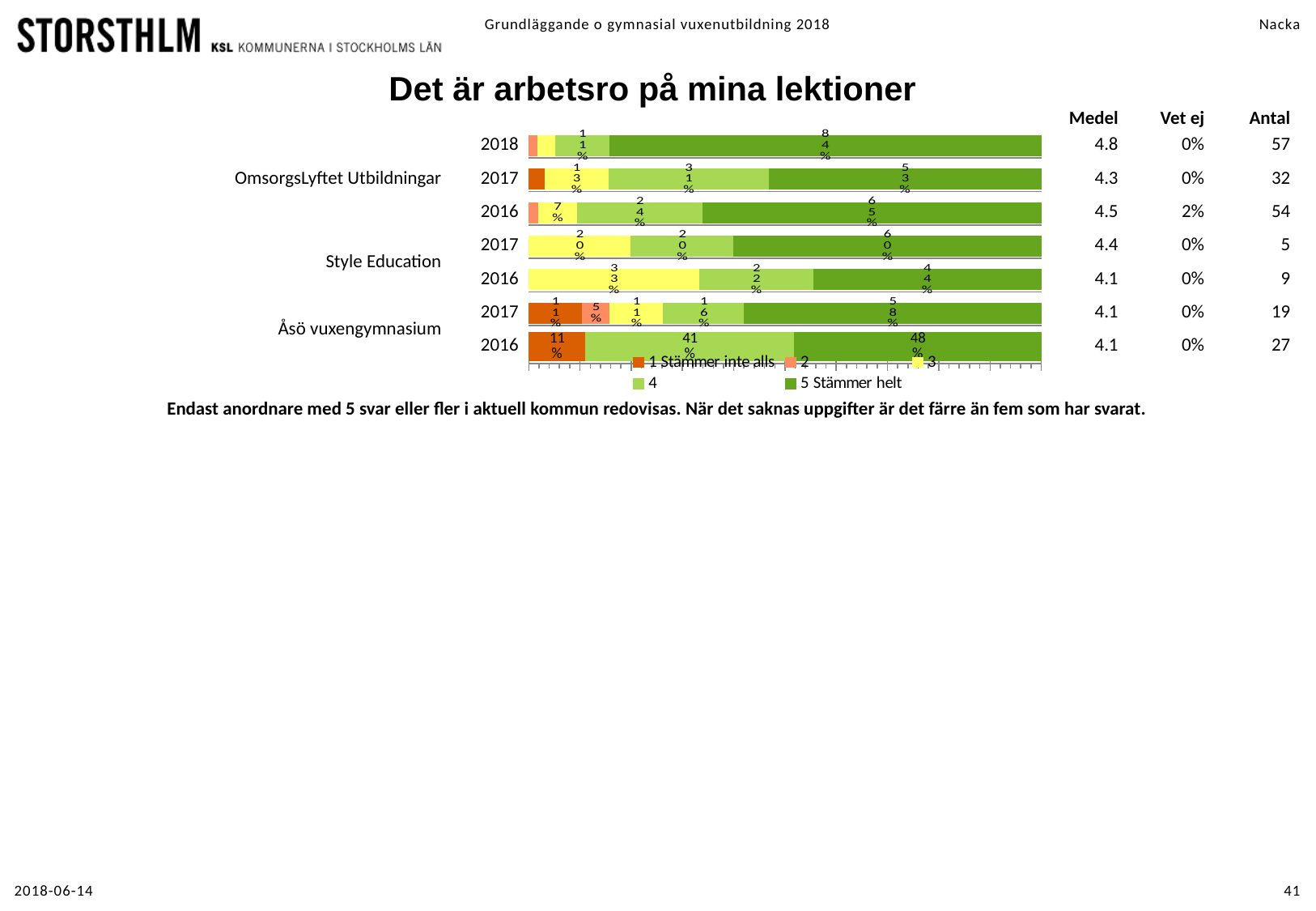
What is the value of the '5 Stämmer helt' segment for Åsö vuxengymnasium 2016? 48% What is the first entry in the chart legend? 1 Stämmer inte alls What kind of chart is shown on the slide? Stacked bar chart Which bar has the largest '5 Stämmer helt' segment? OmsorgsLyftet Utbildningar 2018 What is the value of the '4' segment for Åsö vuxengymnasium 2016? 41% What is the title of the chart? Det är arbetsro på mina lektioner What is the value of the '5 Stämmer helt' segment for OmsorgsLyftet Utbildningar 2018? 84% For Åsö vuxengymnasium 2016, which segment is larger: '4' or '5 Stämmer helt'? 5 Stämmer helt For Åsö vuxengymnasium 2016, what is the difference between the '5 Stämmer helt' segment and the '4' segment? 7 percentage points How many bars (year rows) are plotted in the chart? 7 How many series does the chart legend list? 5 What is the value of the '1 Stämmer inte alls' segment for Åsö vuxengymnasium 2016? 11%